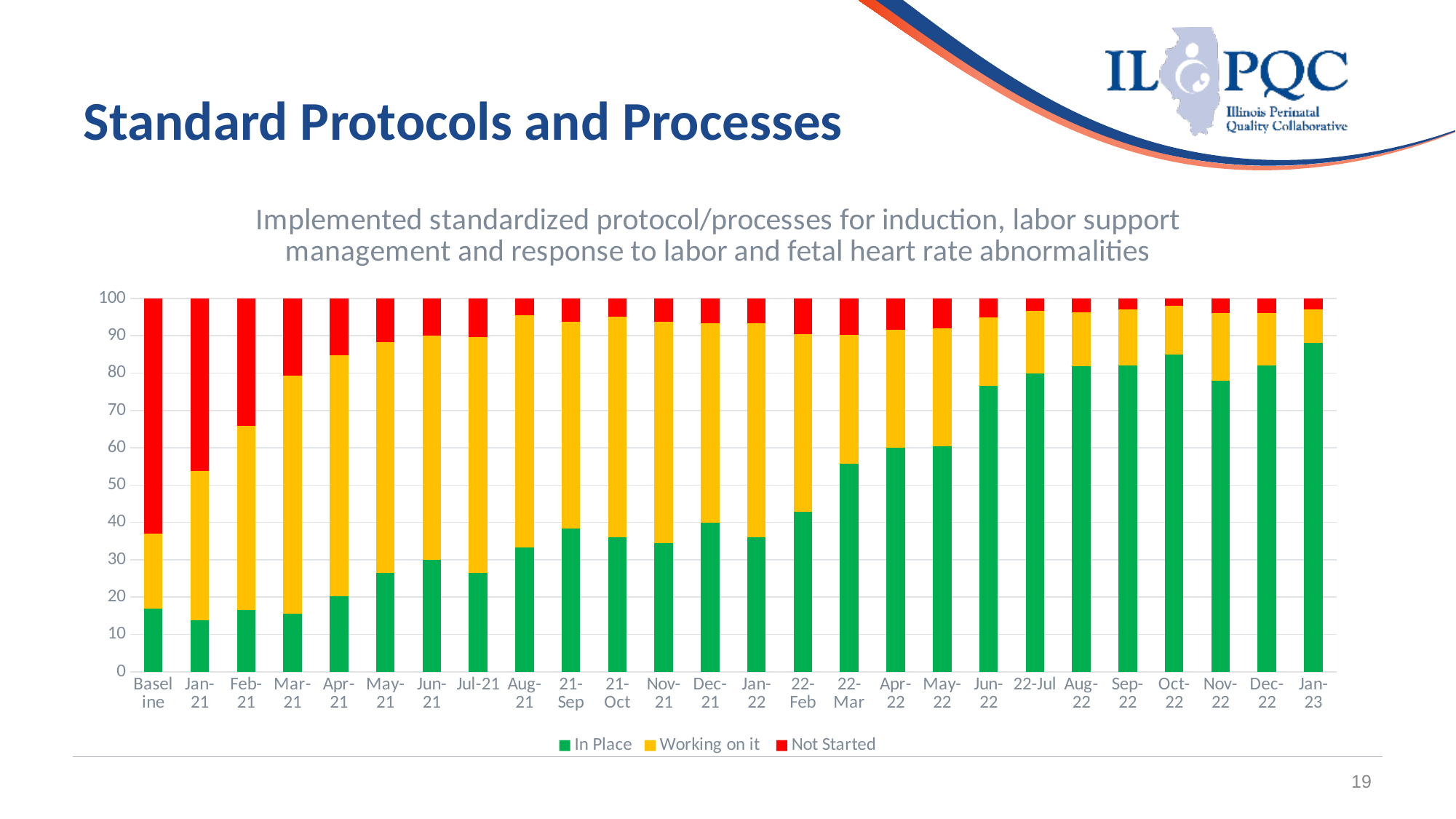
How many series does the legend list? 3 Does the 'In Place' series generally rise or fall from Baseline to Jan-23? Rise Which category has the highest 'Not Started' value? Baseline Is the 'Working on it' value for Apr-21 greater or less than 60? greater How many time-period categories are plotted along the x axis? 26 Is the 'In Place' value for Jan-23 greater or less than 80? greater What kind of chart is shown on the slide? Stacked bar chart Which category has the highest 'In Place' value? Jan-23 Which colour represents the 'Not Started' series? Red Is the 'In Place' value for Baseline greater or less than 20? less What are the three series named in the legend? In Place, Working on it, Not Started